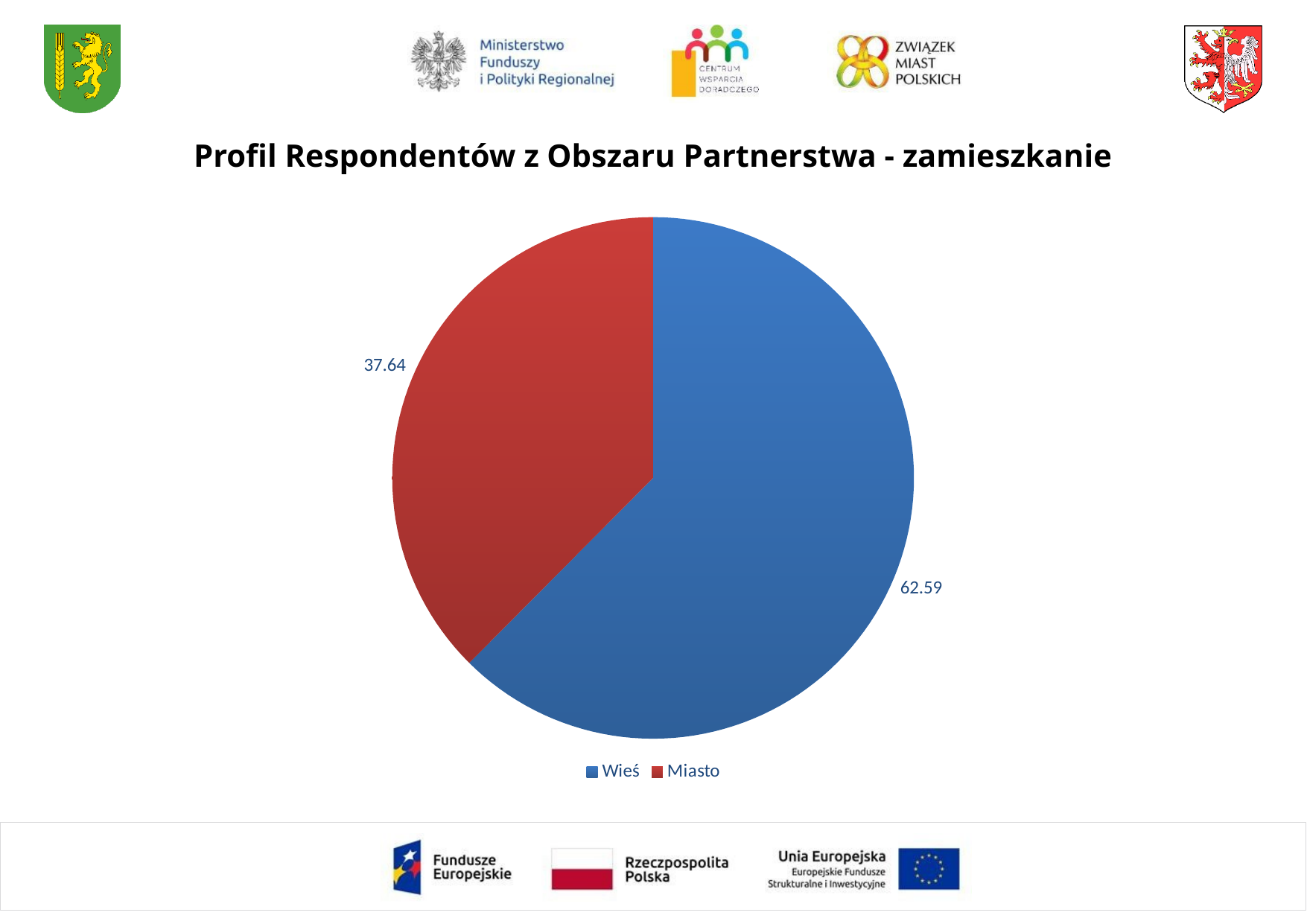
What is the title of the chart? Profil Respondentów z Obszaru Partnerstwa - zamieszkanie How many entries does the legend list? 2 What kind of chart is shown on the slide? Pie chart Which is larger, Wieś or Miasto? Wieś What is the difference between the values for Wieś and Miasto? 24.95 What is the value for Miasto? 37.64 What is the value for Wieś? 62.59 What colour is the Miasto slice? Red How many categories does the pie chart show? 2 Which category has the largest slice? Wieś Which category has the smallest slice? Miasto